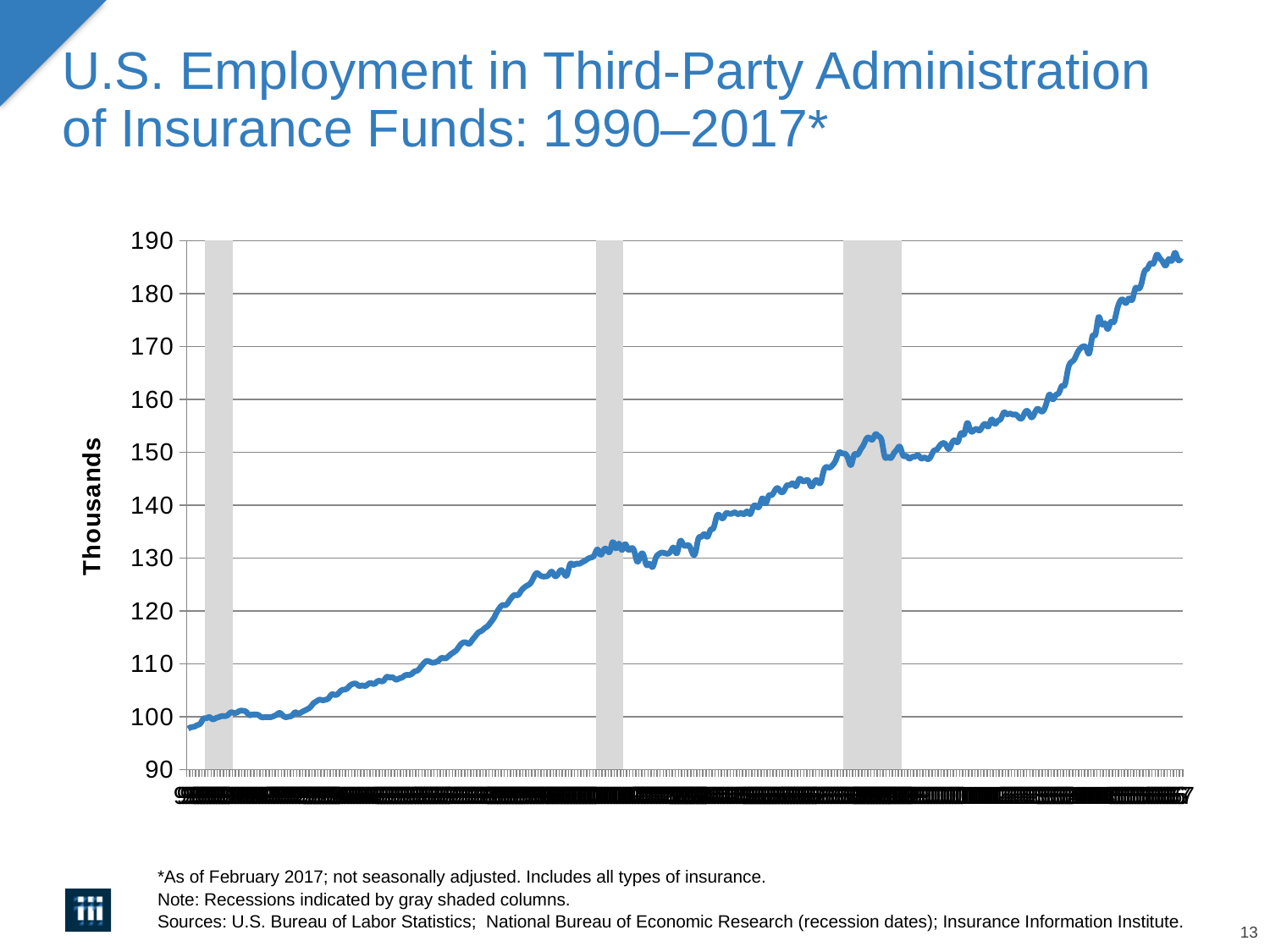
What is the label on the vertical axis of the chart? Thousands Is the value at the start of the series (1990) greater or less than 110? less What is the title of the chart? U.S. Employment in Third-Party Administration of Insurance Funds: 1990–2017* Overall, do the values rise or fall from 1990 to 2017 along the x axis? rise Which end of the series, 1990 or 2017, has the higher employment value? 2017 Does the line reach its lowest point near the beginning or near the end of the period? near the beginning Is the highest value reached by the line greater or less than 190? less Does the line reach its highest point near the beginning or near the end of the period? near the end Is the value at the end of the series (2017) greater or less than 180? greater What kind of chart is shown on the slide? line chart What is the lowest value shown on the vertical axis? 90